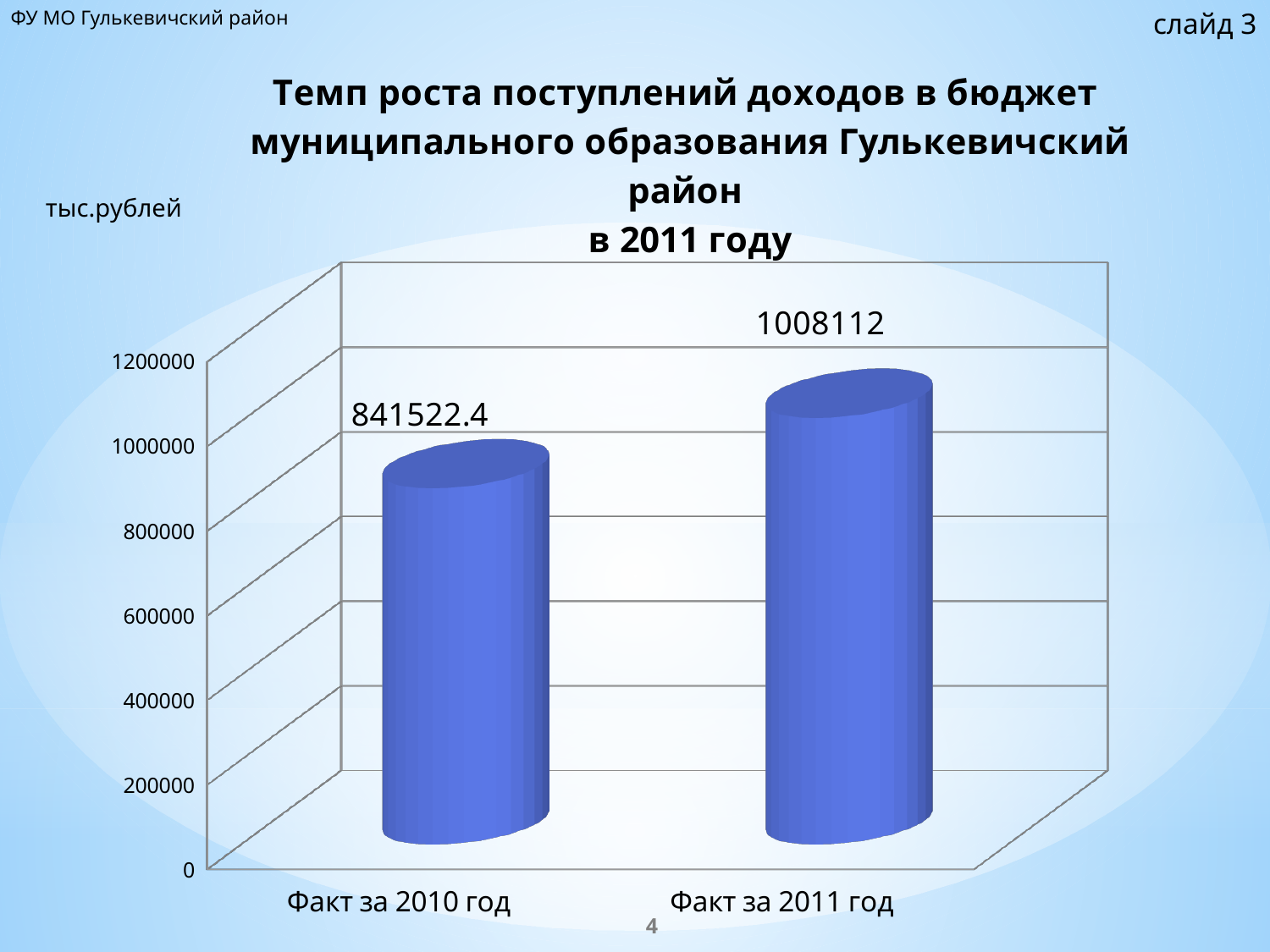
Is the value for Факт за 2011 год greater or less than 1000000? greater What kind of chart is shown on the slide? bar chart How many categories are shown on the chart? 2 What is the value for Факт за 2010 год? 841522.4 Is the value for Факт за 2010 год greater or less than 1000000? less Do the values rise or fall from Факт за 2010 год to Факт за 2011 год? rise What is the difference between the values for Факт за 2011 год and Факт за 2010 год? 166589.6 What is the value for Факт за 2011 год? 1008112 Which category has the highest value? Факт за 2011 год Which is larger, the value for Факт за 2010 год or the value for Факт за 2011 год? Факт за 2011 год Which category has the lowest value? Факт за 2010 год What unit of measurement is indicated for the chart values? тыс.рублей